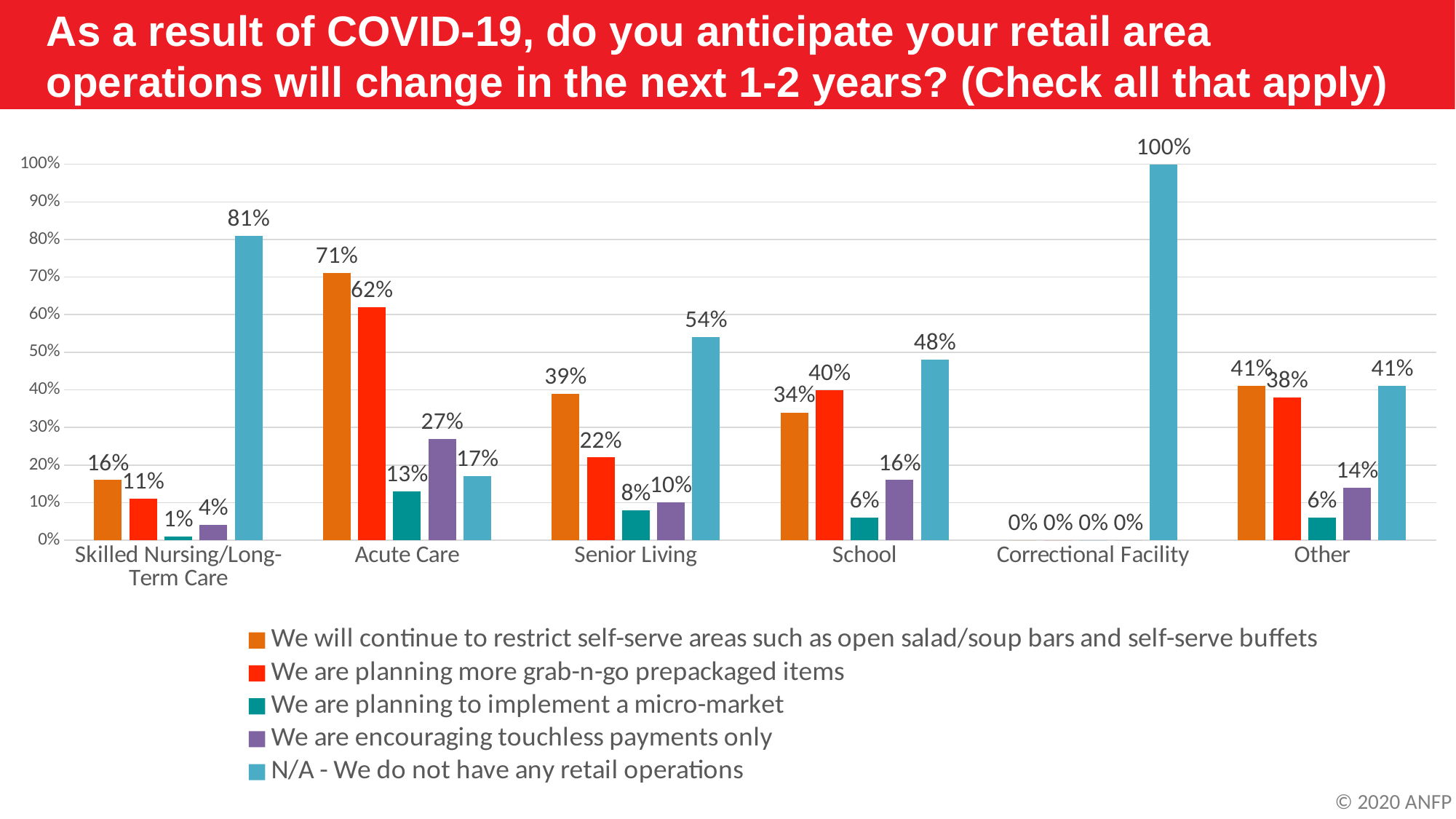
Which colour represents 'We are planning to implement a micro-market' in the legend? Teal Which category has the highest value for 'N/A - We do not have any retail operations'? Correctional Facility What kind of chart is shown on the slide? Bar chart What percentage of School respondents are planning more grab-n-go prepackaged items? 40% What is the difference between the Acute Care values for 'We will continue to restrict self-serve areas' and 'We are planning more grab-n-go prepackaged items'? 9% Which category has the lowest value for 'We are planning to implement a micro-market'? Correctional Facility What is the value for 'N/A - We do not have any retail operations' in the Skilled Nursing/Long-Term Care category? 81% How many categories are shown on the x axis? 6 What is the value for 'We are encouraging touchless payments only' in the Senior Living category? 10% What percentage of Acute Care respondents said they will continue to restrict self-serve areas such as open salad/soup bars and self-serve buffets? 71% How many series does the legend list? 5 In the Other category, which is larger: 'We will continue to restrict self-serve areas' or 'We are planning more grab-n-go prepackaged items'? We will continue to restrict self-serve areas